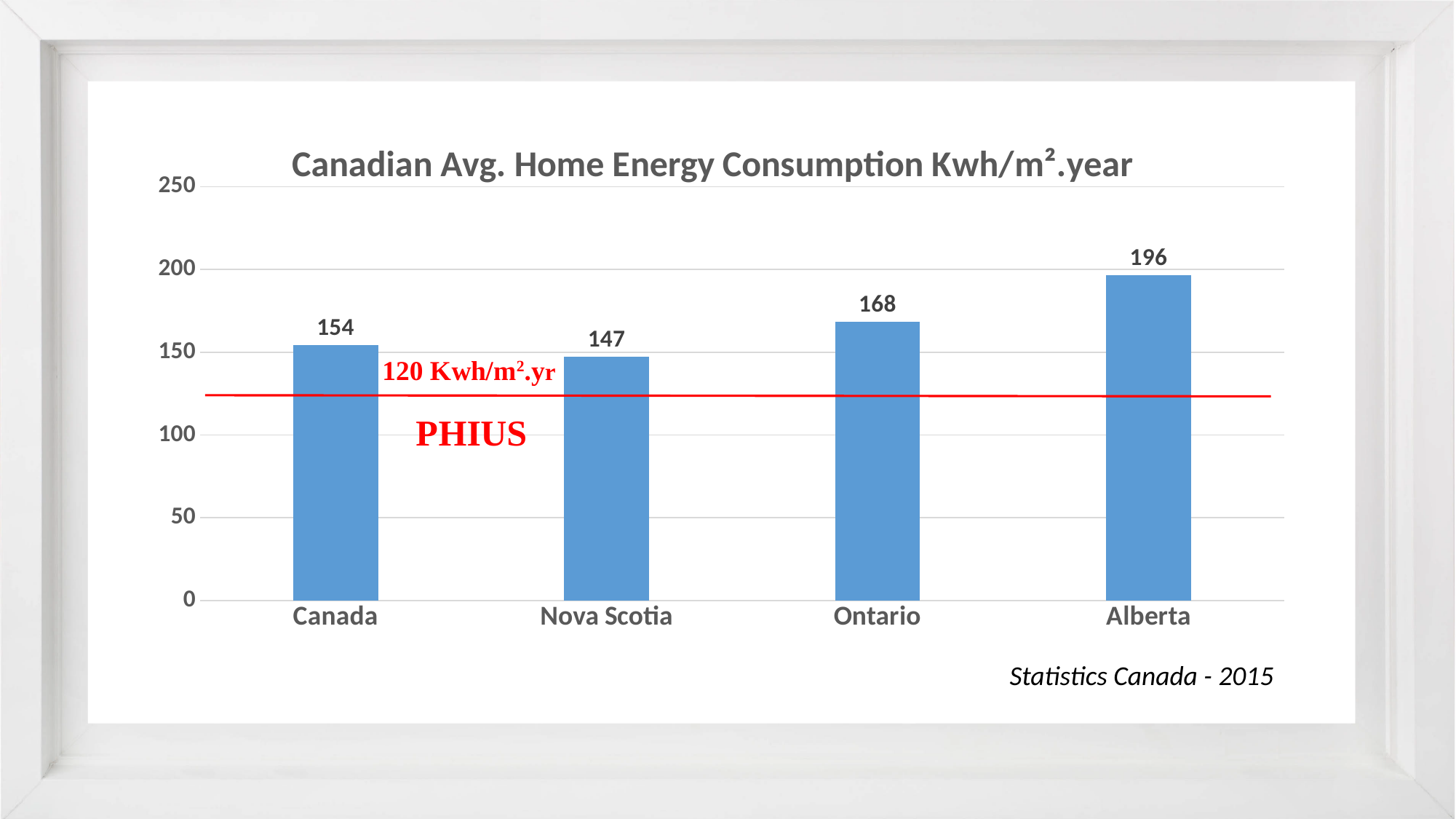
Is the value for Ontario greater or less than 150? greater What kind of chart is this? bar chart What is the difference between the values for Alberta and Nova Scotia? 49 What is the title of the chart? Canadian Avg. Home Energy Consumption Kwh/m².year Which category has the lowest value? Nova Scotia What is the value for Canada? 154 What is the value for Ontario? 168 Which is larger, the value for Ontario or the value for Canada? Ontario What is the value for Alberta? 196 Which category has the highest value? Alberta What is the value for Nova Scotia? 147 How many categories are shown on the x axis? 4